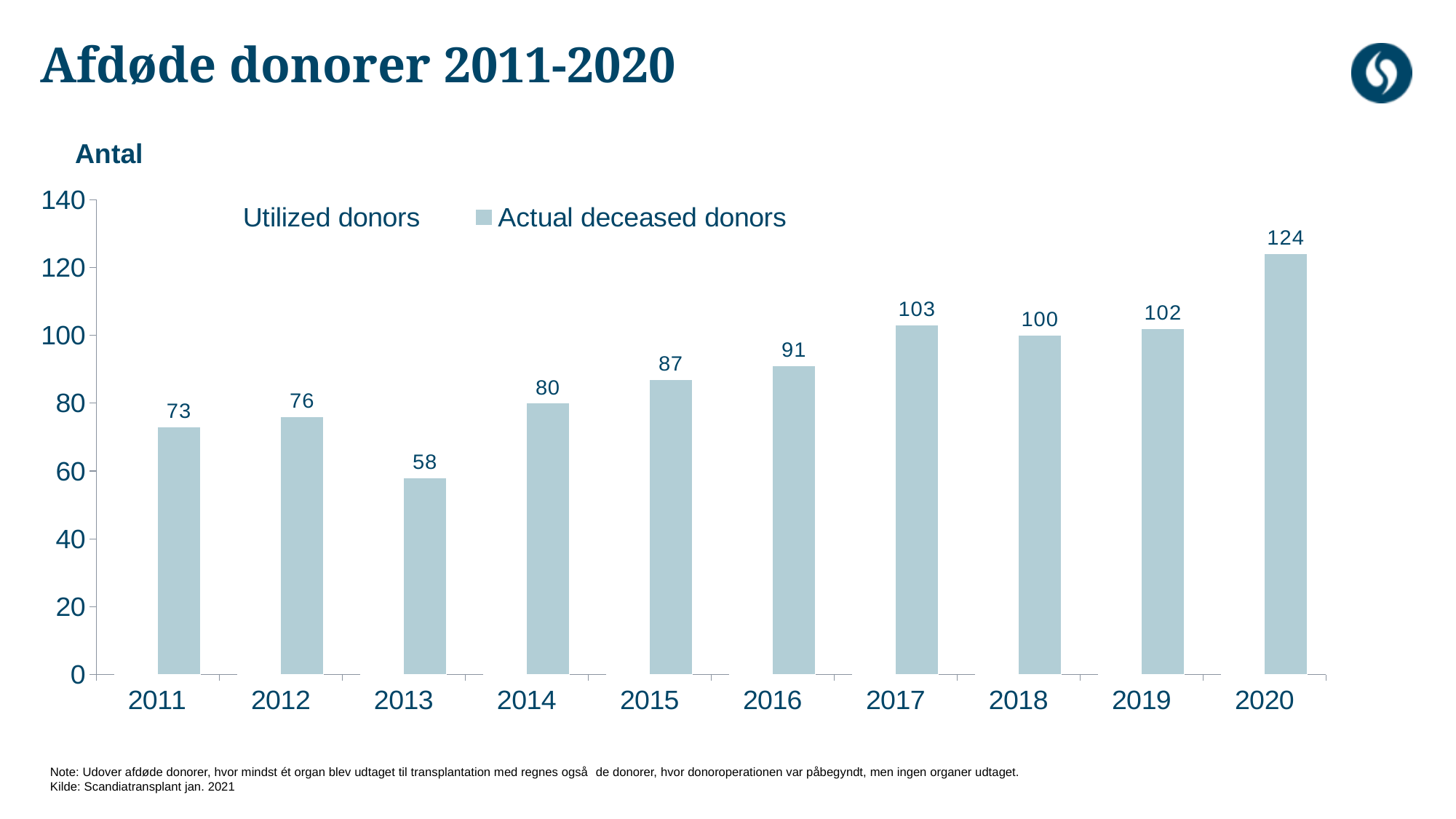
Which year has the highest value for Actual deceased donors? 2020 What is the difference between the Actual deceased donors values for 2014 and 2013? 22 What is the title of the slide? Afdøde donorer 2011-2020 How many series does the legend list? 2 Which year has a larger value for Actual deceased donors, 2015 or 2016? 2016 What is the difference between the Actual deceased donors values for 2020 and 2019? 22 Which year has the lowest value for Actual deceased donors? 2013 What is the value for Actual deceased donors in 2017? 103 What is the value for Actual deceased donors in 2020? 124 How many years are shown on the x axis? 10 What kind of chart is shown on the slide? Bar chart What is the value for Actual deceased donors in 2013? 58